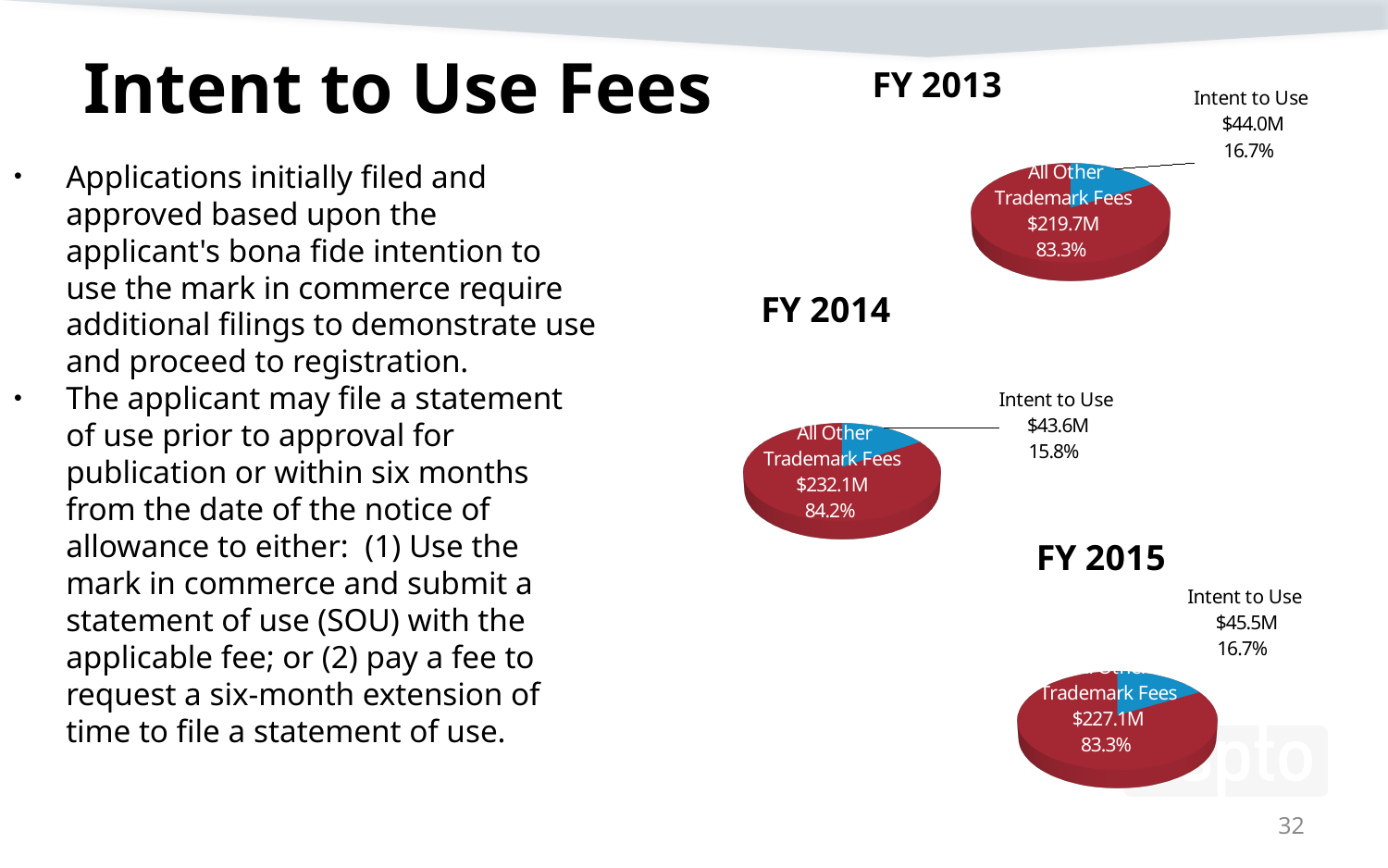
In the FY 2014 chart, which slice is the smallest? Intent to Use In the FY 2014 chart, what is the value for All Other Trademark Fees? $232.1M In the FY 2015 chart, what is the value for Intent to Use? $45.5M How many slices does the FY 2013 pie chart have? 2 In the FY 2014 chart, what share of the pie is Intent to Use? 15.8% In the FY 2013 chart, what share of the pie is All Other Trademark Fees? 83.3% In the FY 2015 chart, which slice is the largest? All Other Trademark Fees In the FY 2015 chart, what is the value for All Other Trademark Fees? $227.1M What kind of chart is the FY 2014 chart? Pie chart In the FY 2013 chart, what is the difference between All Other Trademark Fees and Intent to Use? $175.7M In the FY 2013 chart, what is the value for Intent to Use? $44.0M How many pie charts are shown on the slide? 3